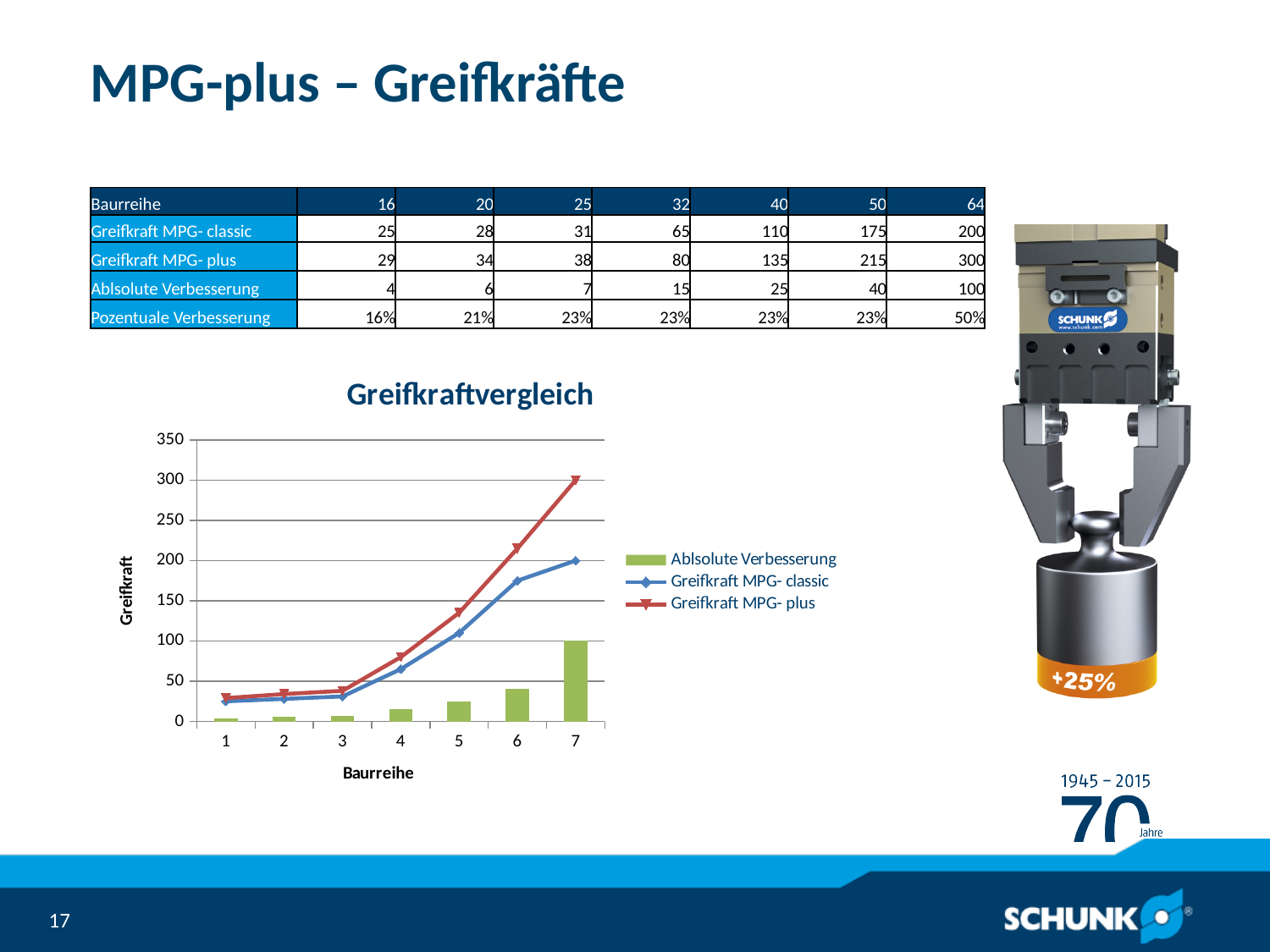
How many series does the chart legend list? 3 At which Baurreihe is the Ablsolute Verbesserung bar highest in the chart? 7 Is the value of Greifkraft MPG- plus at Baurreihe 6 greater or less than 200? greater What is the label of the y axis of the chart? Greifkraft Do the Greifkraft MPG- plus values rise or fall from Baurreihe 1 to 7 in the chart? rise Is the value of Greifkraft MPG- classic at Baurreihe 5 greater or less than 150? less How many categories are shown on the x axis of the chart? 7 What is the value of the Ablsolute Verbesserung bar at Baurreihe 7 in the chart? 100 What is the title of the chart on the slide? Greifkraftvergleich What is the value of the Greifkraft MPG- plus series at Baurreihe 7 in the chart? 300 Which series is higher at Baurreihe 6, Greifkraft MPG- plus or Greifkraft MPG- classic? Greifkraft MPG- plus What is the value of the Greifkraft MPG- classic series at Baurreihe 7 in the chart? 200